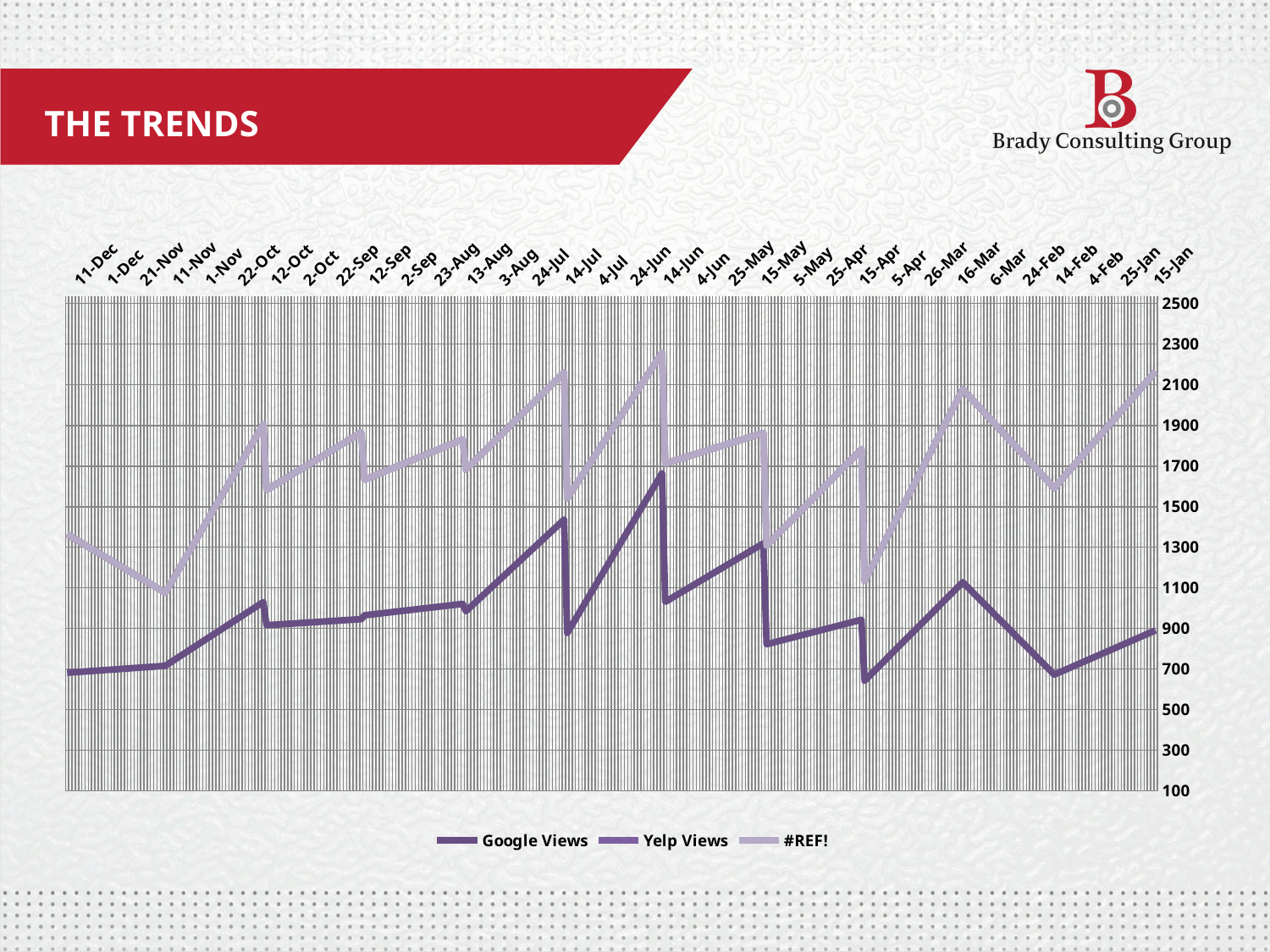
What is the title of the slide containing the chart? THE TRENDS Is the value of the lighter-coloured line at 15-Jan greater or less than 1900? greater Is the value of the darker line at 15-Apr greater or less than 900? less Overall, does the lighter-coloured line rise or fall from the left end (11-Dec) to the right end (15-Jan) of the x axis? rise Is the value of the darker line at 11-Dec greater or less than 900? less What kind of chart is shown on the slide? line chart How many series does the chart legend list? 3 What are the three series names listed in the chart legend? Google Views, Yelp Views, #REF! At 11-Dec, which line is higher: the lighter-coloured line or the darker line? the lighter-coloured line